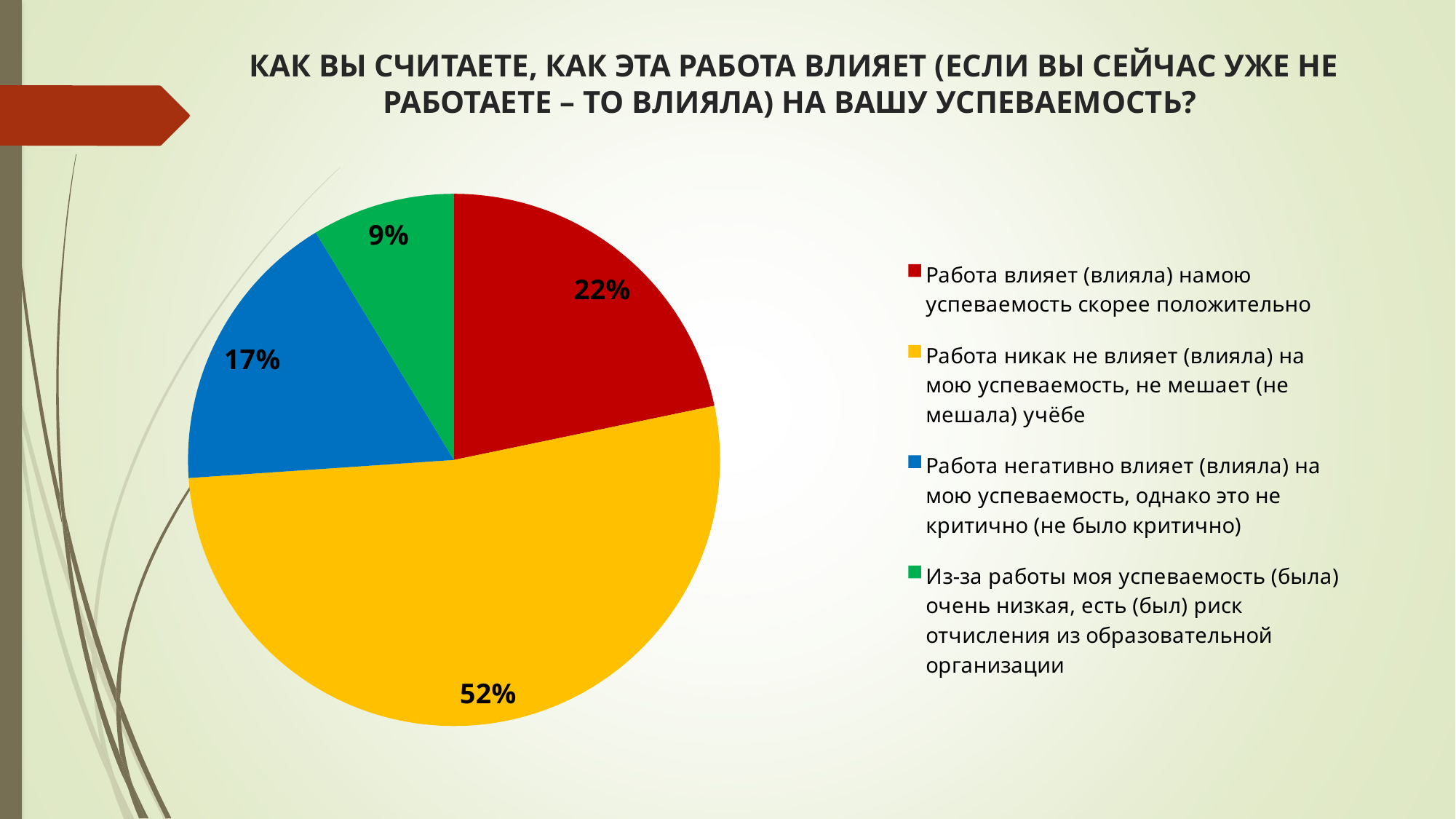
What share of respondents said work does not affect their academic performance at all (Работа никак не влияет (влияла) на мою успеваемость)? 52% Which is larger: the share for 'rather positive' effect or the share for 'negative but not critical' effect? rather positive (22%) What share of respondents said work affects their performance negatively but not critically (Работа негативно влияет (влияла) на мою успеваемость, однако это не критично)? 17% What colour is the slice representing 52%? yellow What colour is the slice representing 9%? green How many slices does the pie chart have? 4 Which answer option has the smallest share of the pie? Из-за работы моя успеваемость (была) очень низкая, есть (был) риск отчисления из образовательной организации Which answer option has the largest share of the pie? Работа никак не влияет (влияла) на мою успеваемость, не мешает (не мешала) учёбе What kind of chart is shown on the slide? pie chart What share of respondents said work affects their academic performance rather positively (Работа влияет (влияла) на мою успеваемость скорее положительно)? 22% What share of respondents said their performance is very low because of work with a risk of expulsion (Из-за работы моя успеваемость (была) очень низкая)? 9% What is the difference in percentage points between the 'no effect' slice (52%) and the 'rather positive' slice (22%)? 30 percentage points